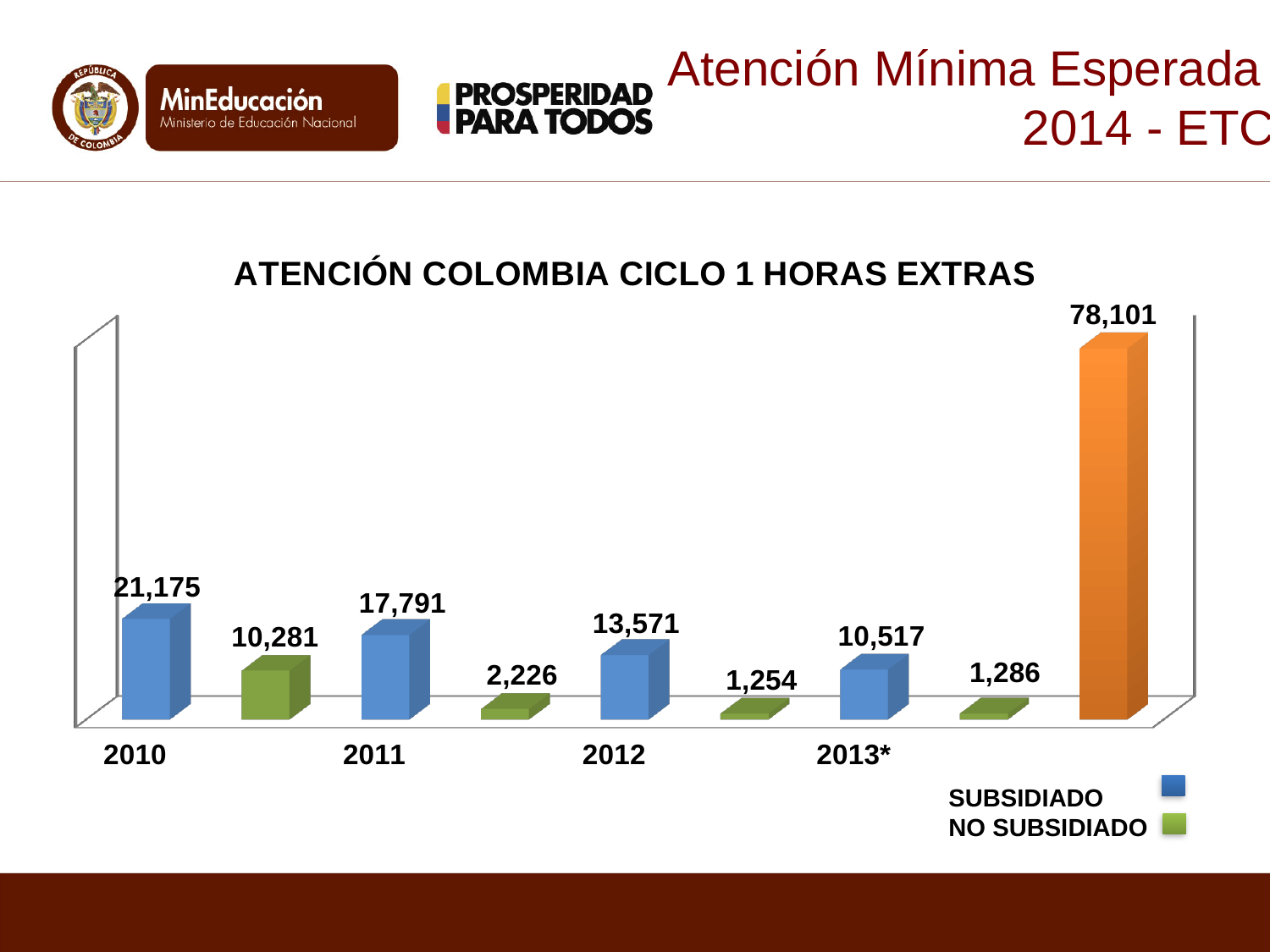
What is the title of the chart? ATENCIÓN COLOMBIA CICLO 1 HORAS EXTRAS What is the SUBSIDIADO value for 2013*? 10,517 What kind of chart is shown on the slide? Bar chart Do the SUBSIDIADO values rise or fall from 2010 to 2013*? Fall What is the difference between the SUBSIDIADO and NO SUBSIDIADO values in 2010? 10,894 Which is larger, the NO SUBSIDIADO value for 2012 or for 2013*? 2013* Which year has the lowest NO SUBSIDIADO value? 2012 What is the NO SUBSIDIADO value for 2011? 2,226 Which year has the highest SUBSIDIADO value? 2010 What value is printed above the tall orange bar at the right of the chart? 78,101 What is the SUBSIDIADO value for 2010? 21,175 How many series does the legend list? 2